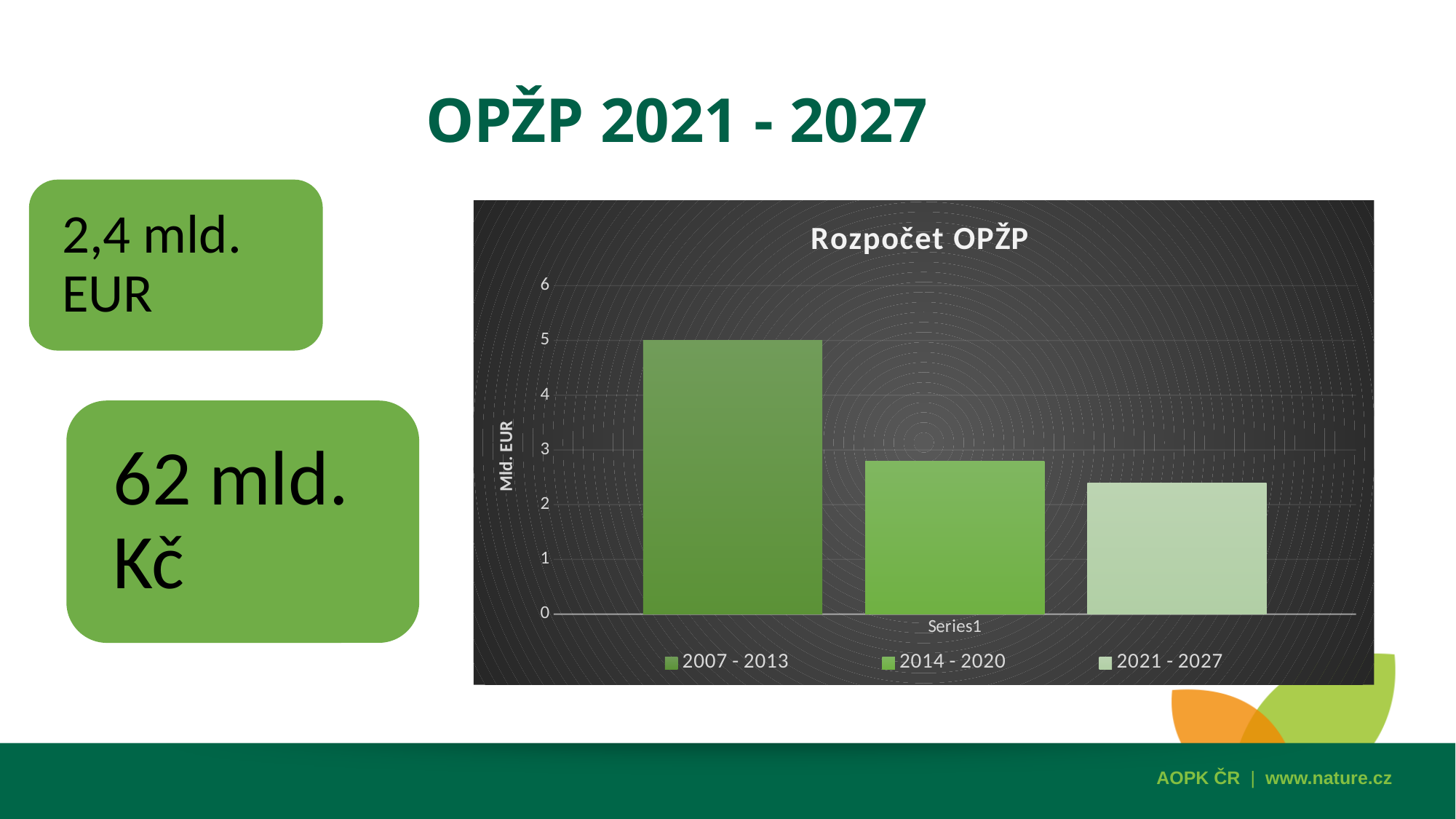
Which is larger, the value for 2014 - 2020 or the value for 2021 - 2027? 2014 - 2020 Which series has the lowest bar in the chart? 2021 - 2027 How many bars are plotted in the chart? 3 What is the title of the chart? Rozpočet OPŽP What type of chart is shown on the slide? bar chart How many series does the chart legend list? 3 What is the value for 2007 - 2013 in the chart? 5 Is the value for 2007 - 2013 greater or less than 4? greater Is the value for 2014 - 2020 greater or less than 3? less What is the label of the vertical axis of the chart? Mld. EUR Is the value for 2021 - 2027 greater or less than 2? greater Which series has the highest bar in the chart? 2007 - 2013